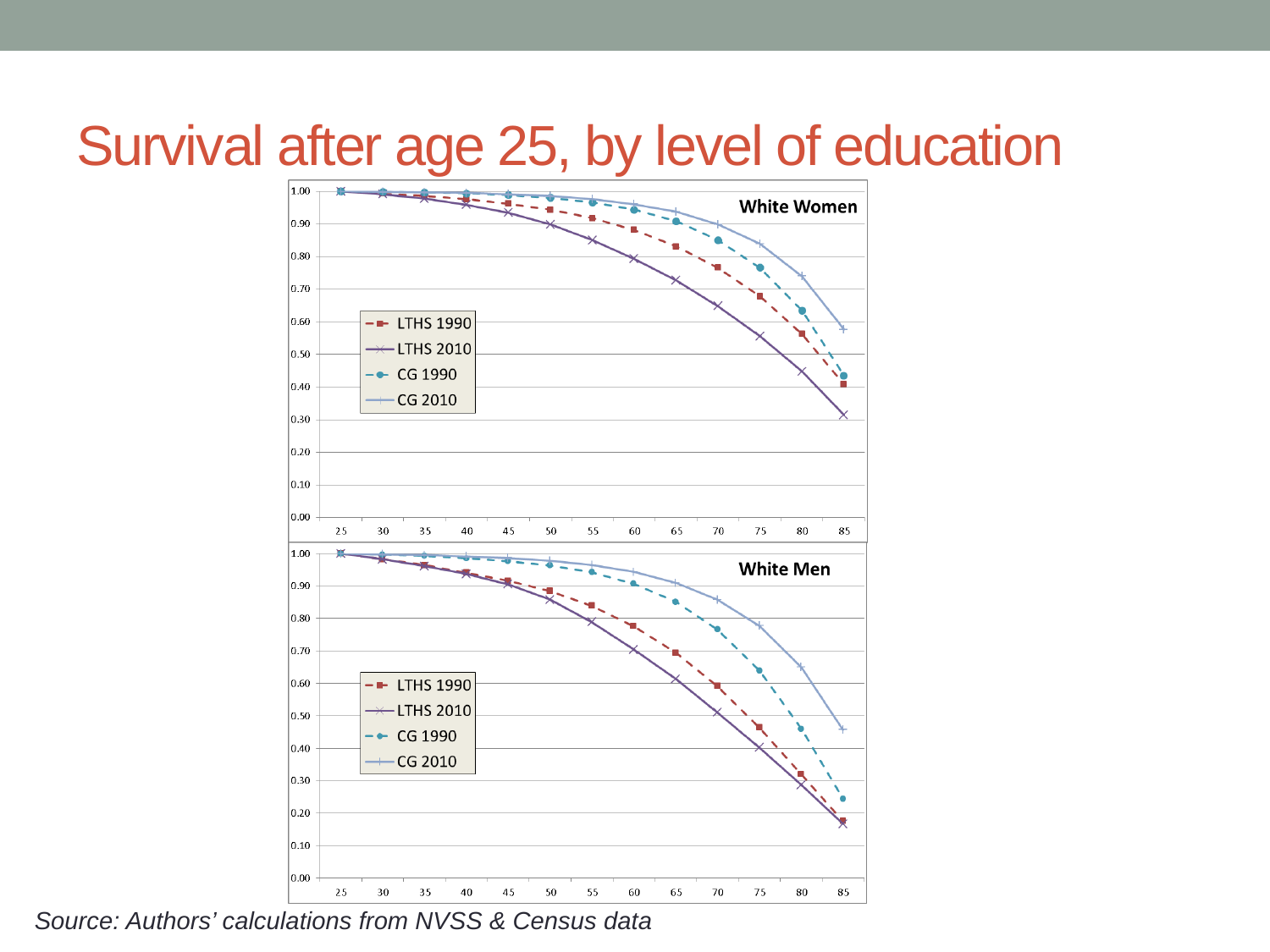
In the White Women chart, is the value for LTHS 2010 at age 85 greater or less than 0.40? less In the White Women chart, which series has the highest value at age 85? CG 2010 How many series does the legend of the White Women chart list? 4 In the White Men chart, at age 85, which is larger: CG 2010 or CG 1990? CG 2010 In the White Women chart, which series has the lowest value at age 85? LTHS 2010 In the White Women chart, do the survival values rise or fall as age increases? fall What kind of chart is the top chart (White Women)? line chart In the White Men chart, is the value for LTHS 1990 at age 85 greater or less than 0.30? less What are the four series listed in the legend of the White Men chart? LTHS 1990, LTHS 2010, CG 1990, CG 2010 In the White Men chart, which series has the highest value at age 85? CG 2010 In the White Women chart, is the value for CG 2010 at age 85 greater or less than 0.50? greater How many age points are plotted along the x axis of the White Men chart? 13